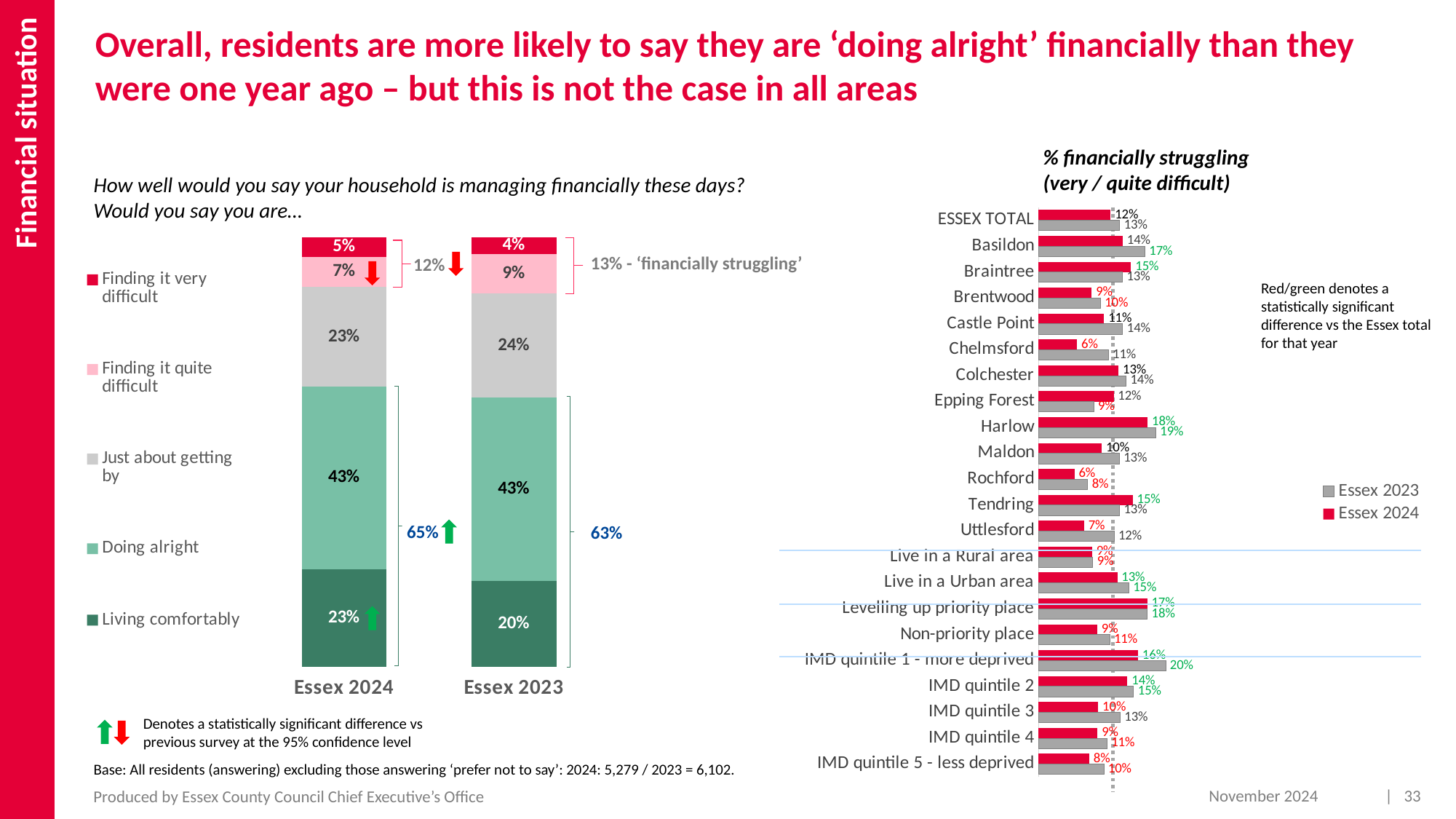
In the '% financially struggling' chart, what is the Essex 2024 value for Chelmsford? 6% In the left stacked bar chart, what is the difference between the 'Just about getting by' share for Essex 2023 and Essex 2024? 1% In the '% financially struggling' chart, what is the Essex 2023 value for 'IMD quintile 1 - more deprived'? 20% In the '% financially struggling' chart, which district has the highest Essex 2024 value? Harlow In the '% financially struggling' chart, what is the Essex 2023 value for Harlow? 19% In the '% financially struggling' chart, what is the difference between the Essex 2023 and Essex 2024 values for Uttlesford? 5% What type of chart is the '% financially struggling' chart on the right? Bar chart In the left stacked bar chart, what percentage of Essex 2024 residents said they are 'Living comfortably'? 23% In the '% financially struggling' chart, how many series does the legend list? 2 In the '% financially struggling' chart, which is larger for Tendring: the Essex 2024 value or the Essex 2023 value? Essex 2024 In the left stacked bar chart, how many categories does the legend list? 5 In the left stacked bar chart, what percentage of Essex 2023 residents said they are 'Finding it quite difficult'? 9%